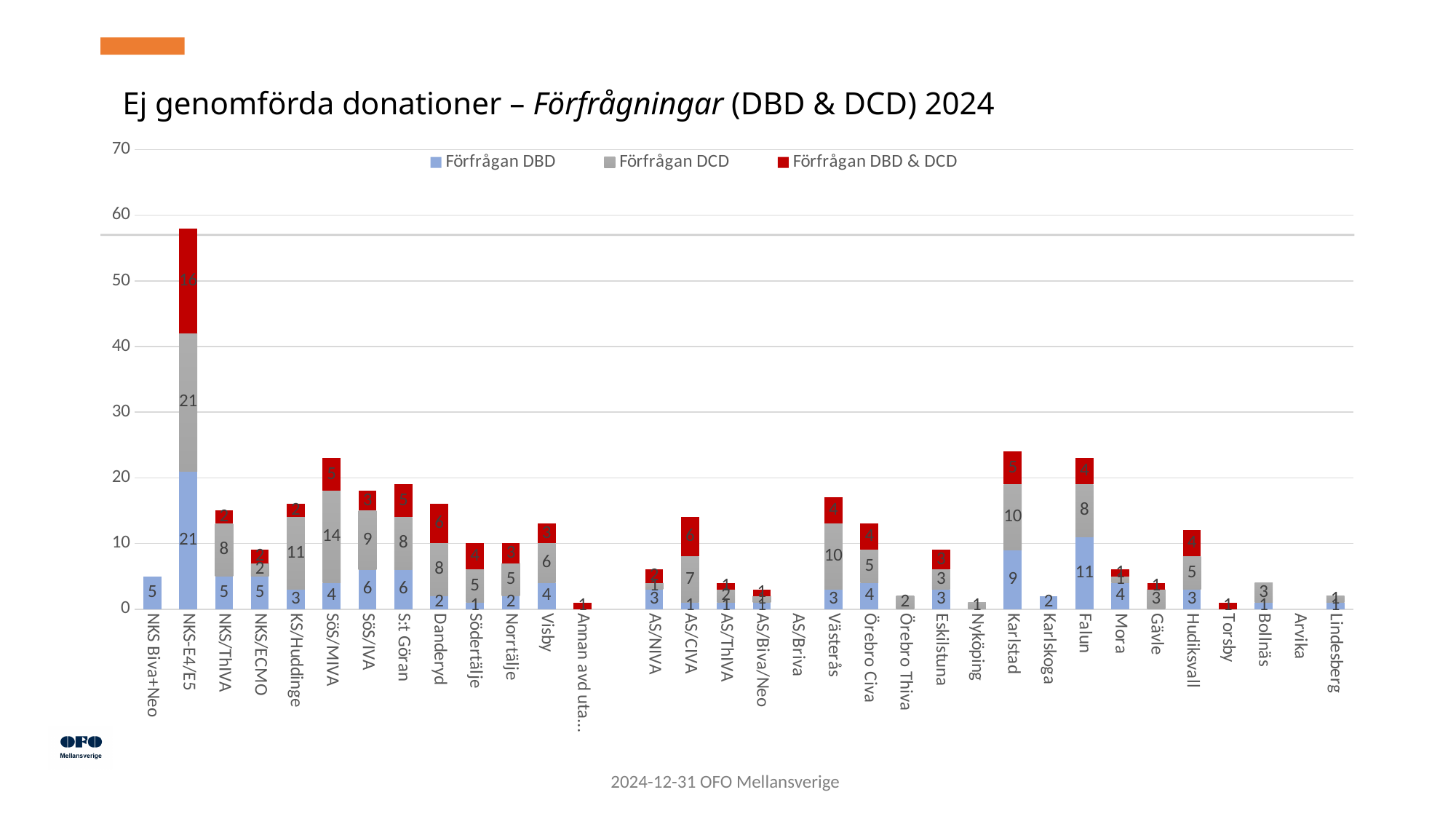
Is the total stacked value for NKS-E4/E5 greater or less than 50? greater Which series is shown in red in the legend? Förfrågan DBD & DCD How many categories are shown on the x axis? 33 What is the total of the stacked bar for Karlstad? 24 What is the Förfrågan DBD value for Falun? 11 What kind of chart is shown on the slide? Stacked bar chart Which has the larger Förfrågan DBD value, Karlstad or SöS/IVA? Karlstad Which category has the tallest stacked bar? NKS-E4/E5 What is the Förfrågan DCD value for SöS/MIVA? 14 What is the difference between the Förfrågan DCD values for Västerås and Danderyd? 2 How many series does the legend list? 3 What is the Förfrågan DBD & DCD value for NKS-E4/E5? 16